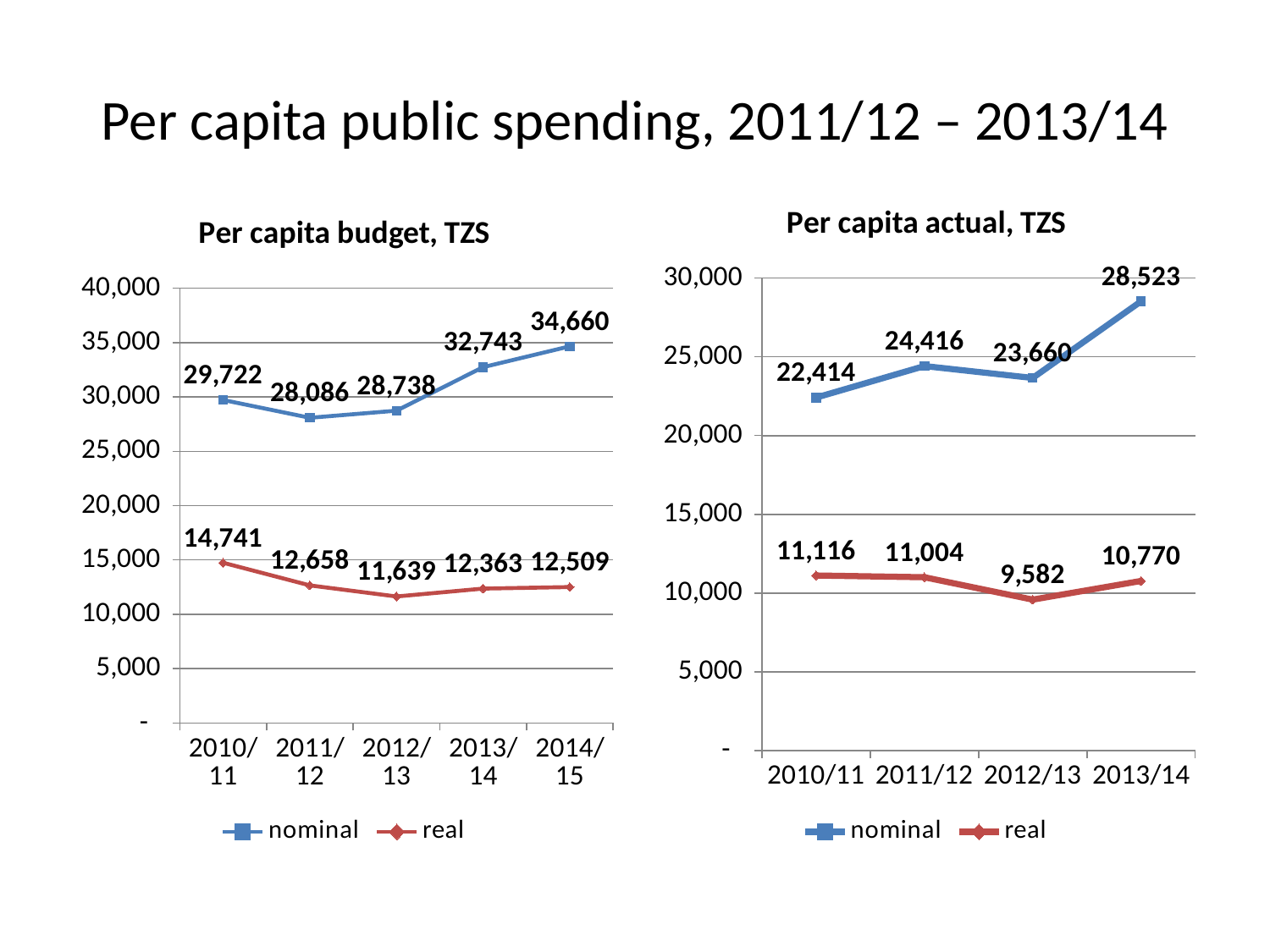
How many series does the legend of the 'Per capita actual, TZS' chart list? 2 In the 'Per capita actual, TZS' chart, which year has the highest nominal value? 2013/14 In the 'Per capita budget, TZS' chart, what is the real value for 2012/13? 11,639 In the 'Per capita actual, TZS' chart, is the real value for 2010/11 larger or smaller than the real value for 2013/14? larger How many years are shown on the x axis of the 'Per capita budget, TZS' chart? 5 In the 'Per capita budget, TZS' chart, what is the nominal value for 2014/15? 34,660 What kind of chart is the 'Per capita actual, TZS' chart? line chart In the 'Per capita budget, TZS' chart, what is the difference between the nominal and real values for 2010/11? 14,981 In the 'Per capita actual, TZS' chart, what is the real value for 2012/13? 9,582 In the 'Per capita budget, TZS' chart, which year has the lowest nominal value? 2011/12 In the 'Per capita actual, TZS' chart, what is the difference between the nominal values for 2013/14 and 2012/13? 4,863 In the 'Per capita actual, TZS' chart, what is the nominal value for 2011/12? 24,416